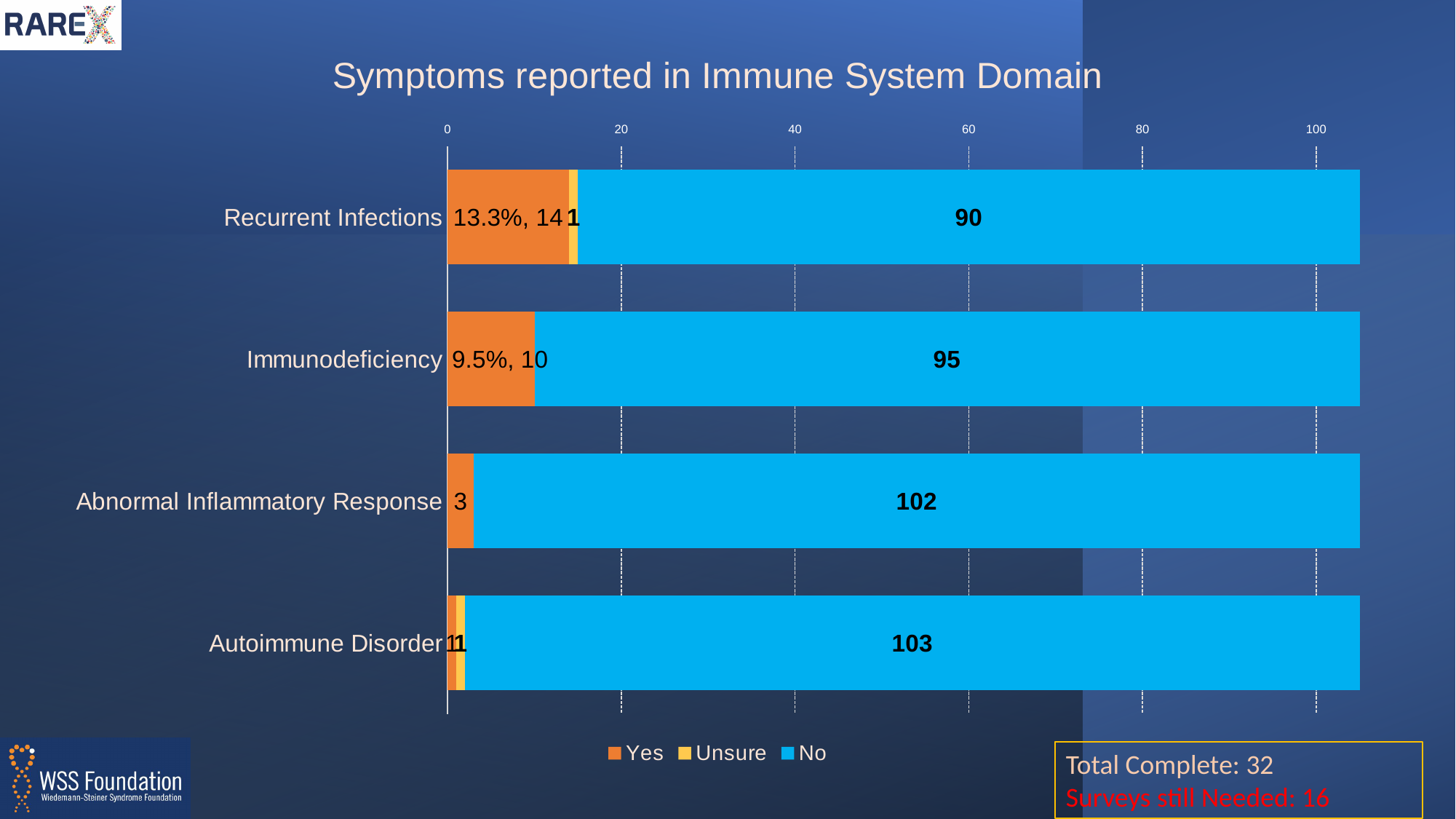
What is the difference between the 'No' values for Abnormal Inflammatory Response and Immunodeficiency? 7 How many series does the legend list? 3 What kind of chart is shown? Stacked bar chart How many categories are shown on the chart? 4 Which category has the highest 'No' value? Autoimmune Disorder What is the total of the stacked bar for Recurrent Infections? 105 What percentage is shown for 'Yes' on Immunodeficiency? 9.5% Which has a larger 'Yes' value, Recurrent Infections or Immunodeficiency? Recurrent Infections What is the title of the chart? Symptoms reported in Immune System Domain How many respondents answered 'Yes' for Recurrent Infections? 14 Which category has the lowest 'No' value? Recurrent Infections What is the 'No' value for Immunodeficiency? 95